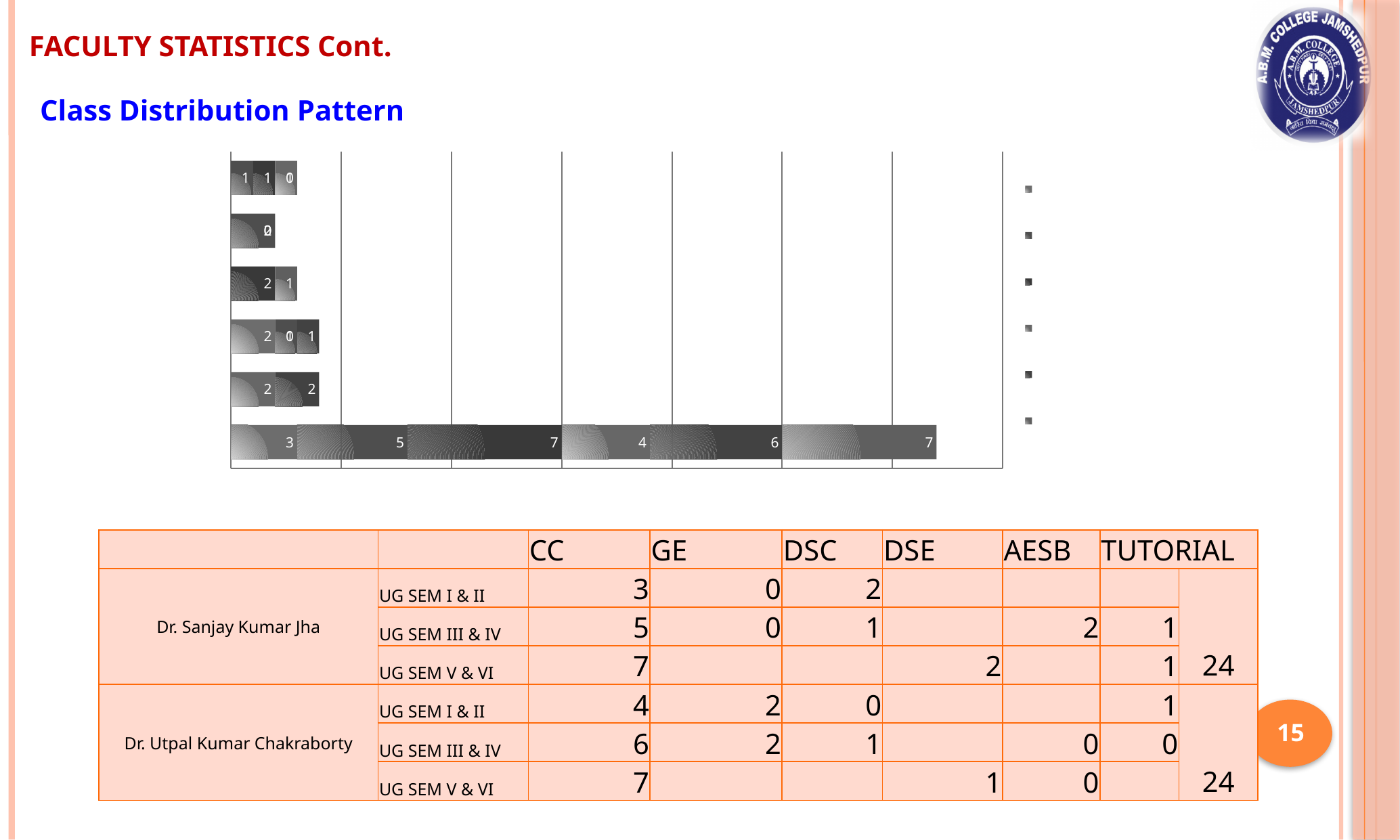
How many segments make up the bottom stacked bar in the chart? 6 Are the bars in the chart drawn horizontally or vertically? horizontally What kind of chart is shown on the slide? bar chart What is the total of the bottom (longest) stacked bar in the chart? 32 What is the value of the first (leftmost) segment of the bottom bar in the chart? 3 How many entries does the chart's legend list? 6 How many bars does the chart show? 6